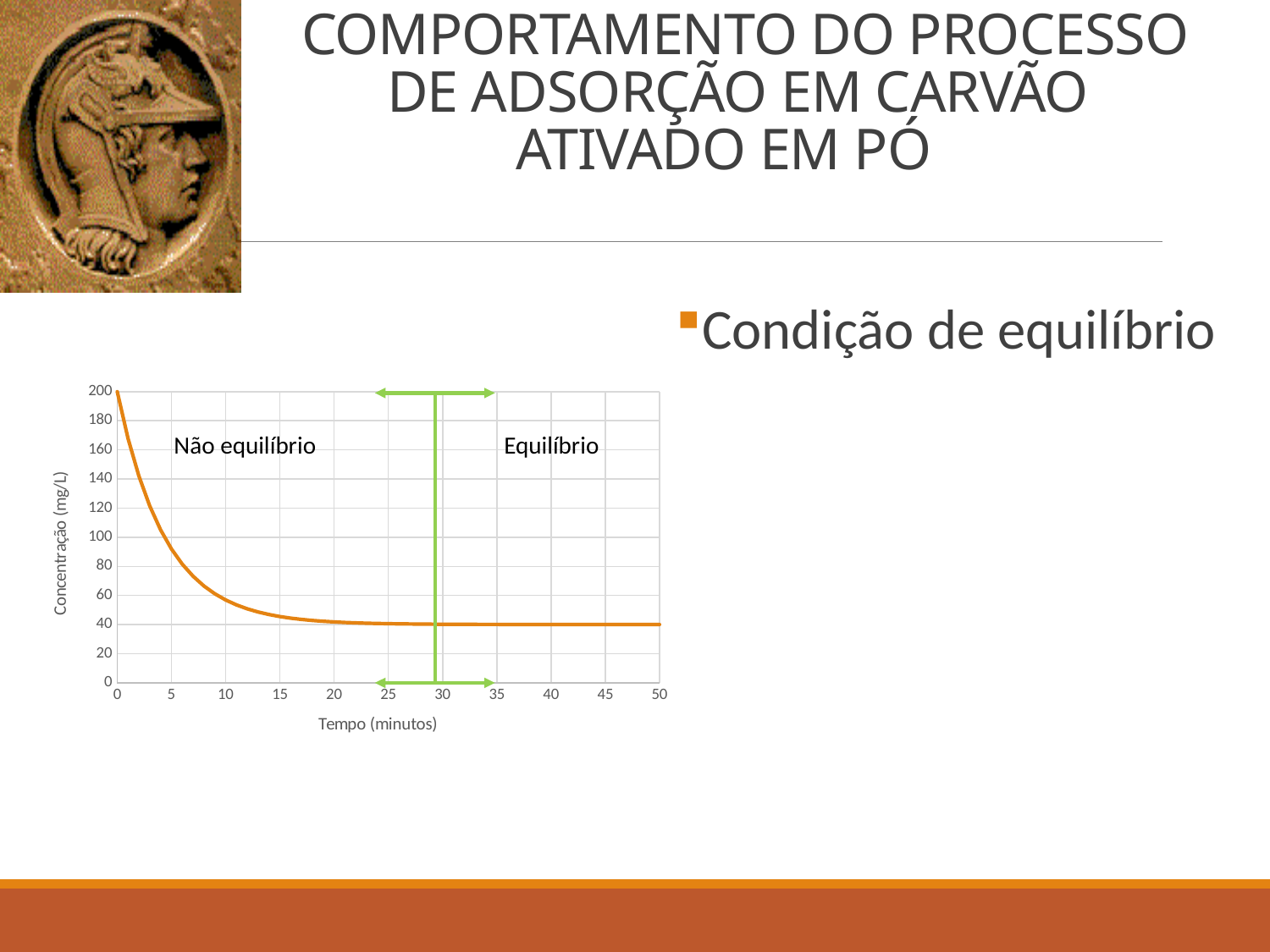
What is the concentration at time 0 minutes? 200 What is the highest value shown on the y axis of the chart? 200 Is the concentration at 20 minutes greater or less than 60? less What is the label of the y axis of the chart? Concentração (mg/L) Is the concentration at 5 minutes greater or less than 60? greater At what time is the concentration highest? 0 Is the concentration at 10 minutes greater or less than 100? less Which is larger, the concentration at 5 minutes or at 15 minutes? 5 minutes Does the concentration rise or fall as time increases along the x axis? fall What is the label of the x axis of the chart? Tempo (minutos) What kind of chart is shown on the slide? line chart